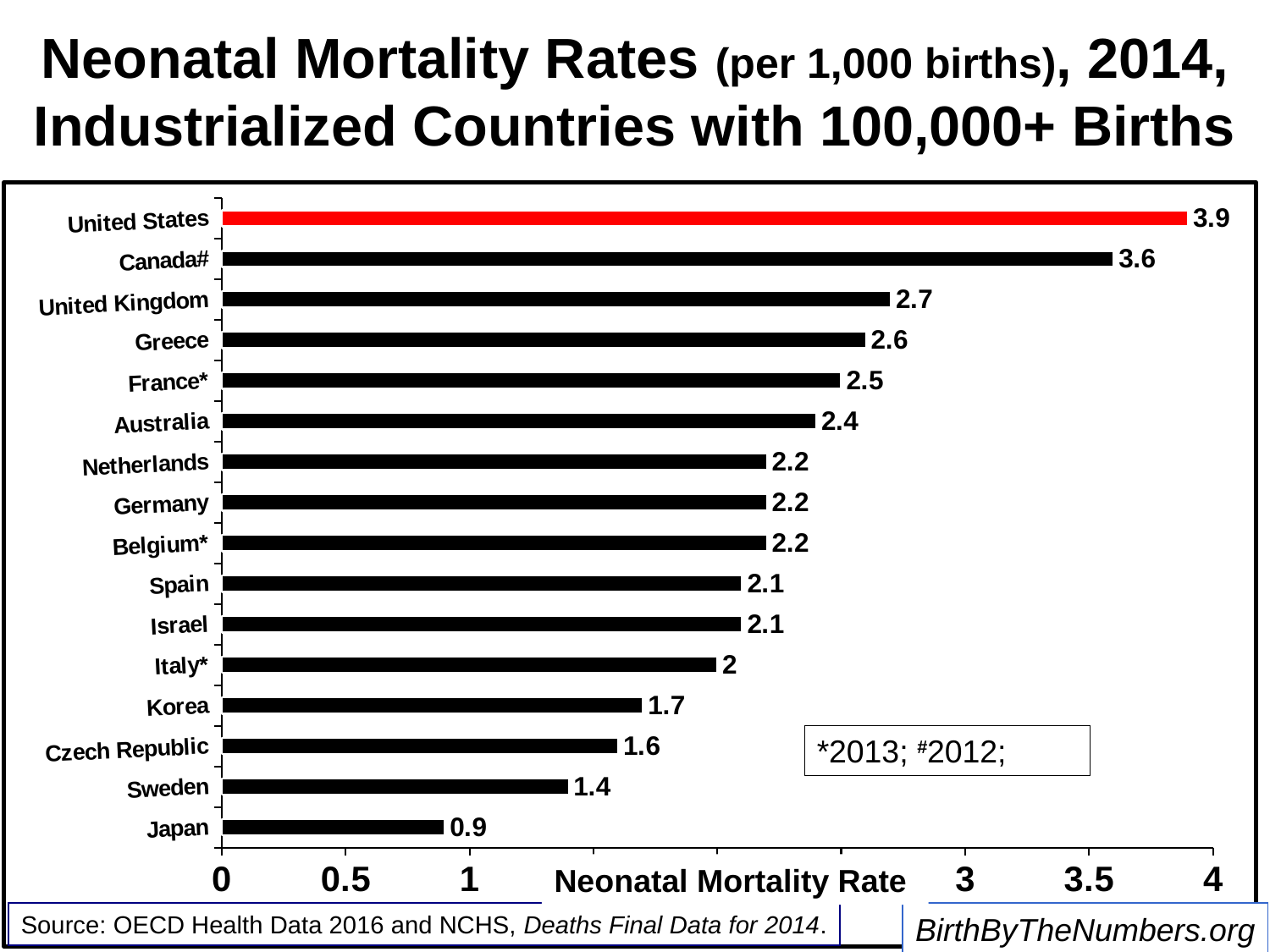
Which country has the highest neonatal mortality rate on the chart? United States How many countries are shown on the chart? 16 What is the neonatal mortality rate for Canada? 3.6 What type of chart is shown on the slide? Bar chart What is the difference between the neonatal mortality rates of the United Kingdom and Sweden? 1.3 Which has a higher neonatal mortality rate, Greece or Australia? Greece What is the neonatal mortality rate for Japan? 0.9 Is the neonatal mortality rate for Korea greater or less than 2? less What is the neonatal mortality rate for the United States? 3.9 Which country has the lowest neonatal mortality rate on the chart? Japan What is the difference between the neonatal mortality rates of the United States and Japan? 3 Which country's bar is coloured red on the chart? United States